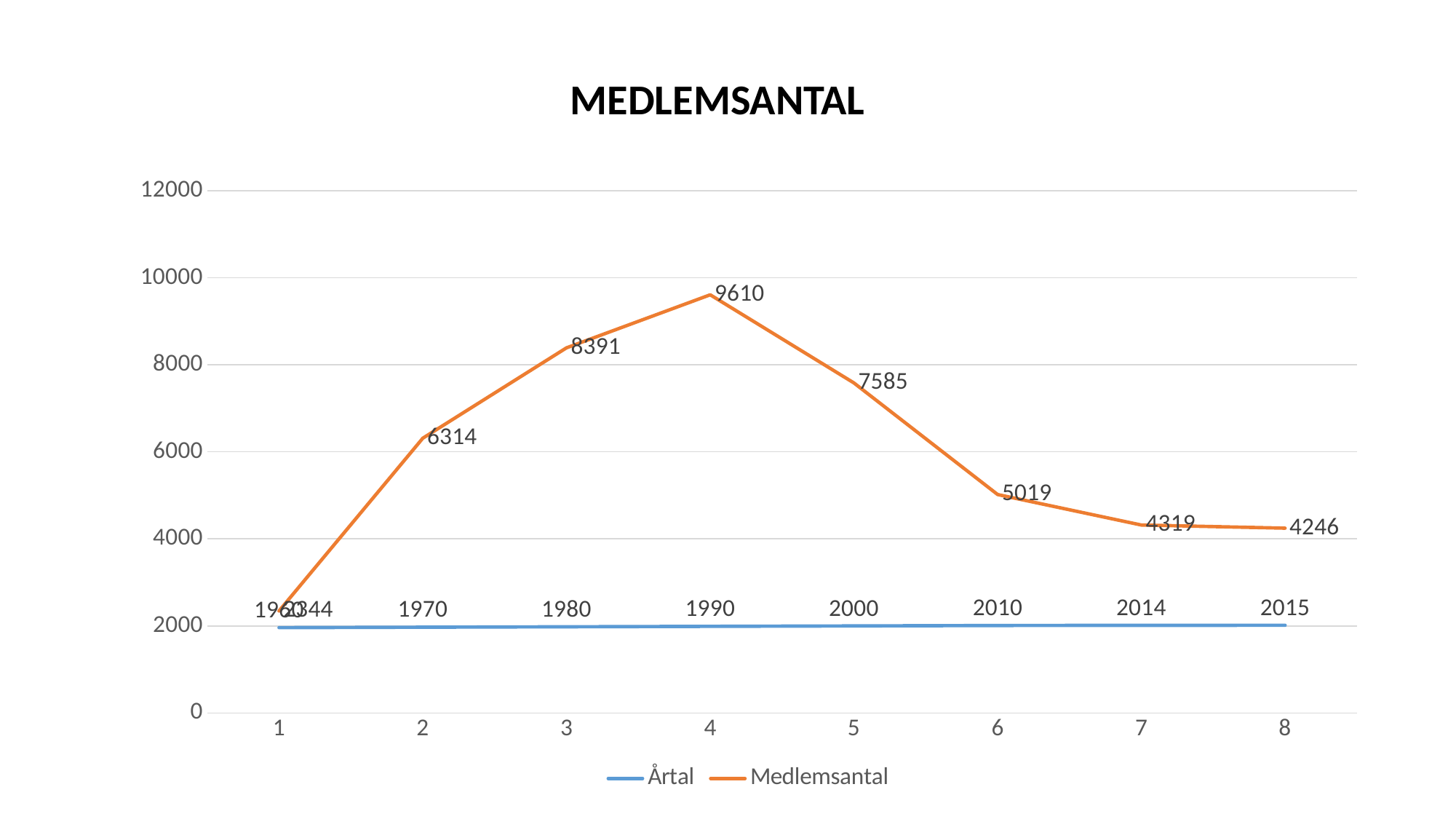
What is the title of the chart? MEDLEMSANTAL What is the Årtal value labelled at x-axis point 5? 2000 At which x-axis point is the Medlemsantal series lowest? 1 How many points are plotted along the x axis for the Medlemsantal series? 8 How many series does the legend list? 2 At which x-axis point is the Medlemsantal series highest? 4 What is the Medlemsantal value at x-axis point 4? 9610 What is the Medlemsantal value at x-axis point 7? 4319 Which is larger, the Medlemsantal value at x-axis point 3 or at point 5? point 3 What type of chart is shown on the slide? line chart What is the difference between the Medlemsantal values at x-axis points 4 and 3? 1219 Does the Medlemsantal series rise or fall from x-axis point 4 to point 8? fall